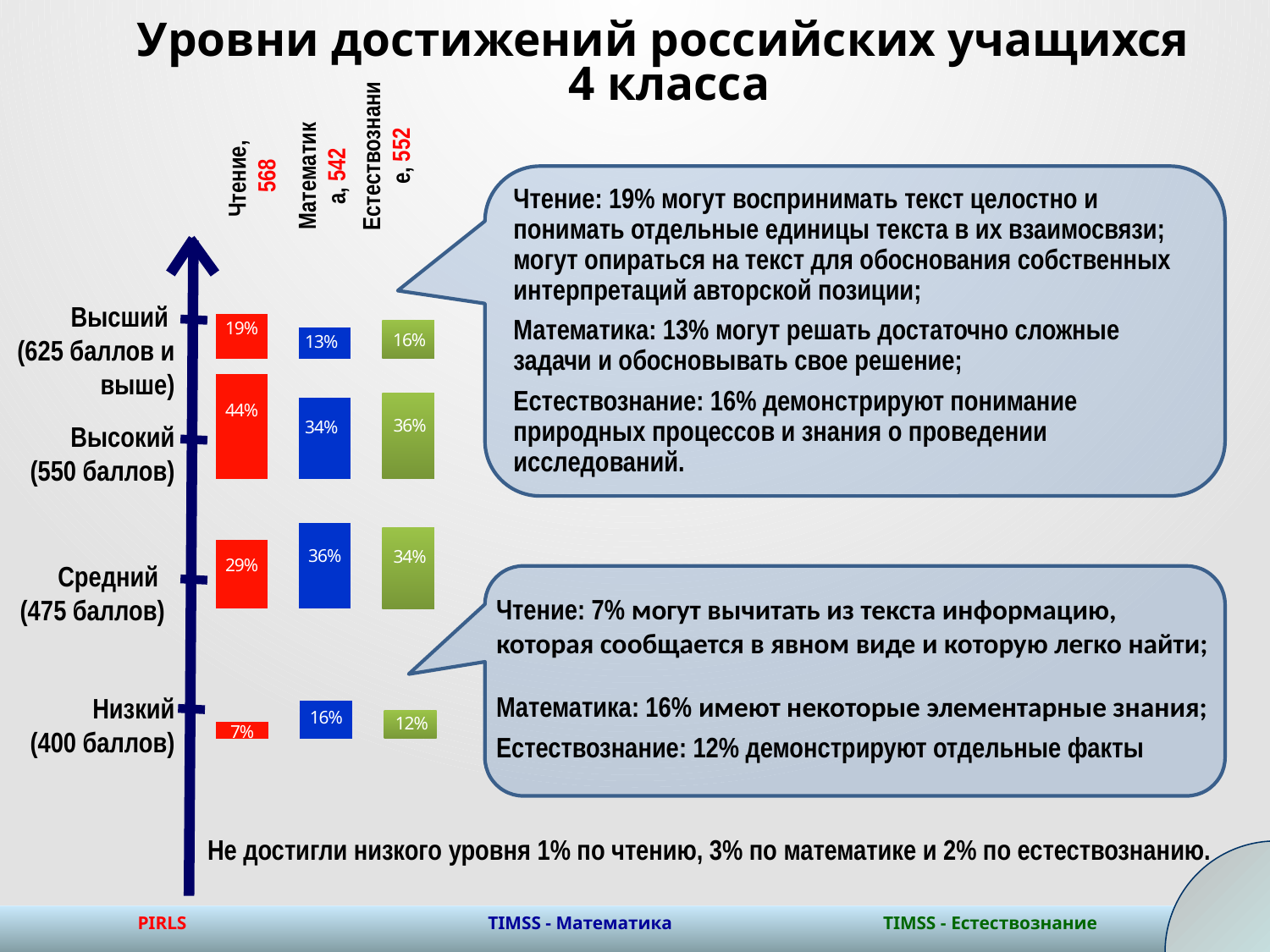
Сколько предметов (столбцов) представлено на диаграмме? 3 Сколько уровней достижений показано на вертикальной шкале диаграммы? 4 На сколько процентных пунктов доля учащихся на высоком уровне по чтению (44%) больше, чем по математике (34%)? 10 Какой процент учащихся достиг высокого уровня (550 баллов) по математике? 34% Каким цветом на диаграмме показан столбец по естествознанию? Зелёным Какой процент российских учащихся 4 класса достиг высшего уровня (625 баллов и выше) по чтению? 19% По какому предмету доля учащихся на низком уровне наименьшая? Чтение Что больше: доля учащихся на среднем уровне по математике или по чтению? По математике (36%) Какой средний балл по математике указан над столбцом? 542 По какому предмету доля учащихся на высшем уровне наибольшая? Чтение Какой процент учащихся находится на среднем уровне (475 баллов) по естествознанию? 34% Какой процент учащихся находится на низком уровне (400 баллов) по чтению? 7%